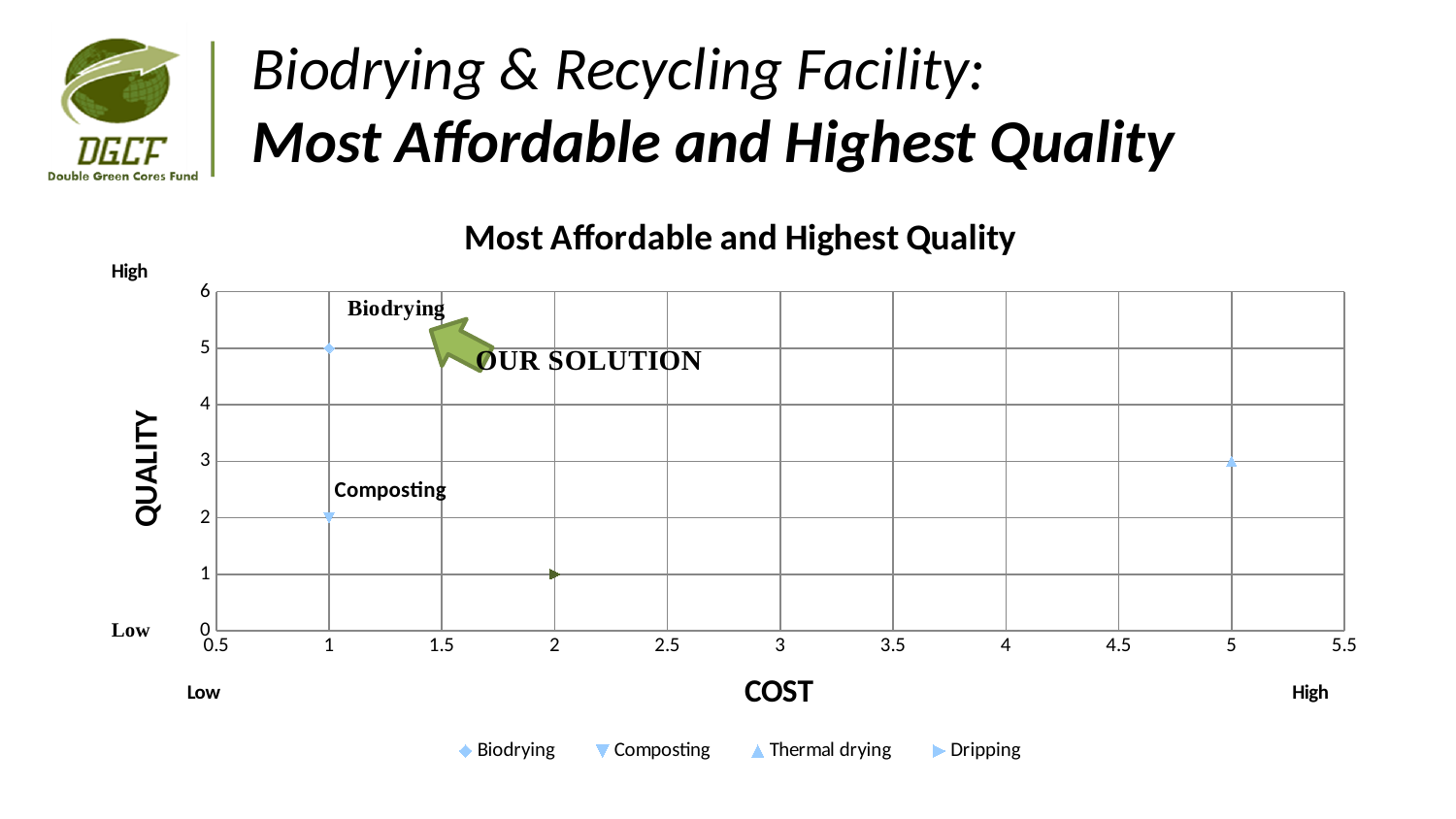
Which has a higher cost value, Thermal drying or Dripping? Thermal drying What is the title of the chart? Most Affordable and Highest Quality How many series does the chart legend list? 4 What is the quality value for Biodrying? 5 What is the quality value for Composting? 2 What is the quality value for Dripping? 1 Which series has the lowest quality value? Dripping What is the difference in quality between Biodrying and Composting? 3 What is the cost value for Biodrying? 1 What kind of chart is shown on the slide? scatter chart Which series has the highest quality value? Biodrying What is the cost value for Thermal drying? 5